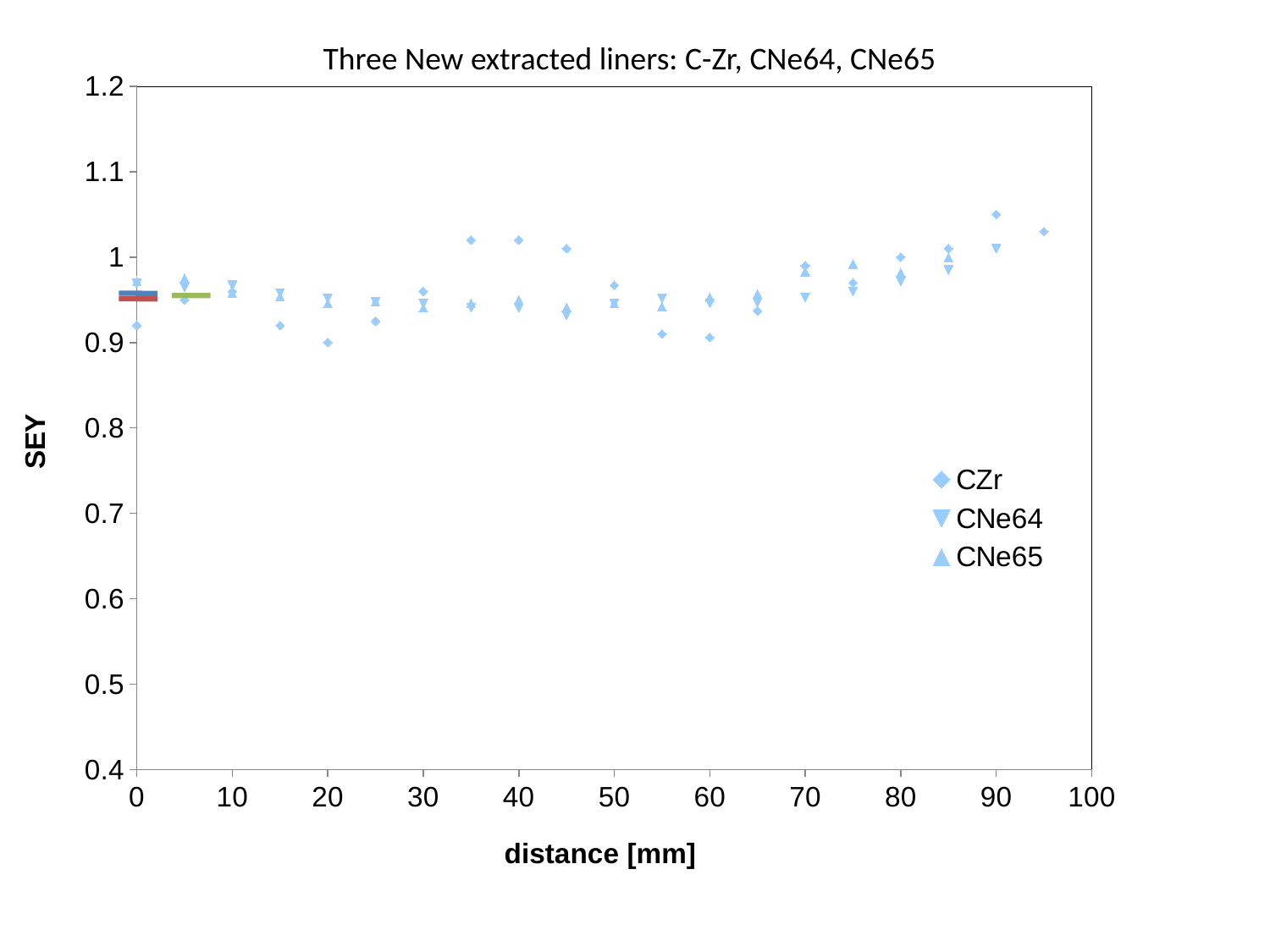
What kind of chart is shown on the slide? scatter chart Is the SEY value for CNe64 at 20 mm greater or less than 0.9? greater At 0 mm, which series has the higher SEY, CZr or CNe64? CNe64 Is the SEY value for CZr at 35 mm greater or less than 1? greater What are the three series named in the legend? CZr, CNe64, CNe65 Do the CZr SEY values rise or fall between 60 mm and 90 mm? rise At 90 mm, which series has the higher SEY, CZr or CNe64? CZr Is the SEY value for CZr at 0 mm greater or less than 1? less What is the title of the chart? Three New extracted liners: C-Zr, CNe64, CNe65 How many series does the legend list? 3 At which distance does the CZr series reach its highest SEY? 90